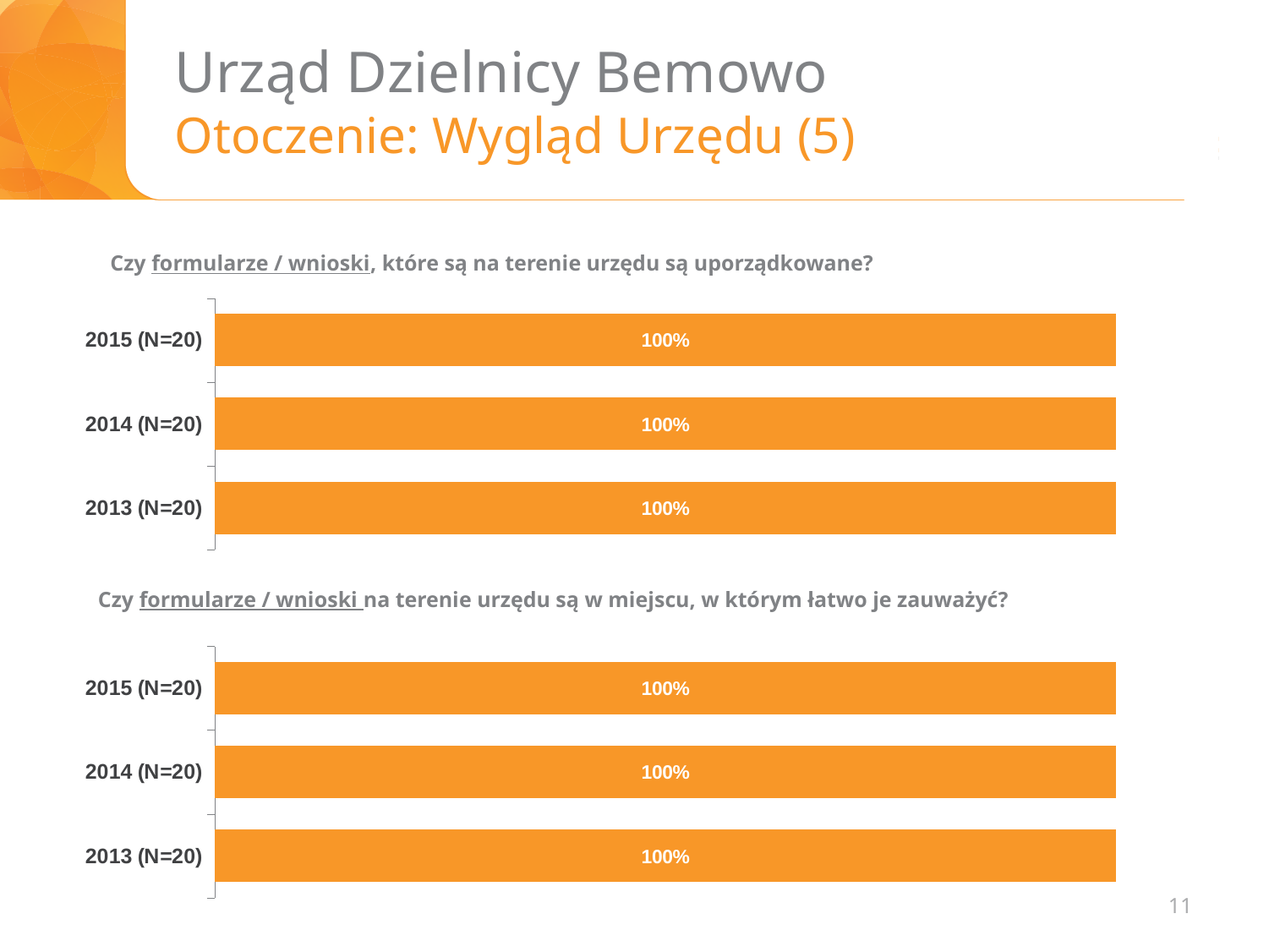
In the top chart, how many categories (years) are shown? 3 In the bottom chart, what is the difference between the values for 2014 (N=20) and 2013 (N=20)? 0% In the top chart, what is the difference between the values for 2015 (N=20) and 2013 (N=20)? 0% In the top chart, what sample size (N) is given for each year? N=20 In the bottom chart, how many bars are plotted? 3 In the bottom chart ("Czy formularze / wnioski na terenie urzędu są w miejscu, w którym łatwo je zauważyć?"), what is the value for 2015 (N=20)? 100% In the bottom chart, do the values change from 2013 to 2015? No, they stay at 100% What colour are the bars in both charts? Orange In the top chart ("Czy formularze / wnioski, które są na terenie urzędu są uporządkowane?"), what is the value for 2013 (N=20)? 100% In the bottom chart ("Czy formularze / wnioski na terenie urzędu są w miejscu, w którym łatwo je zauważyć?"), what is the value for 2014 (N=20)? 100% What kind of chart is the top chart? Bar chart In the top chart ("Czy formularze / wnioski, które są na terenie urzędu są uporządkowane?"), what is the value for 2015 (N=20)? 100%